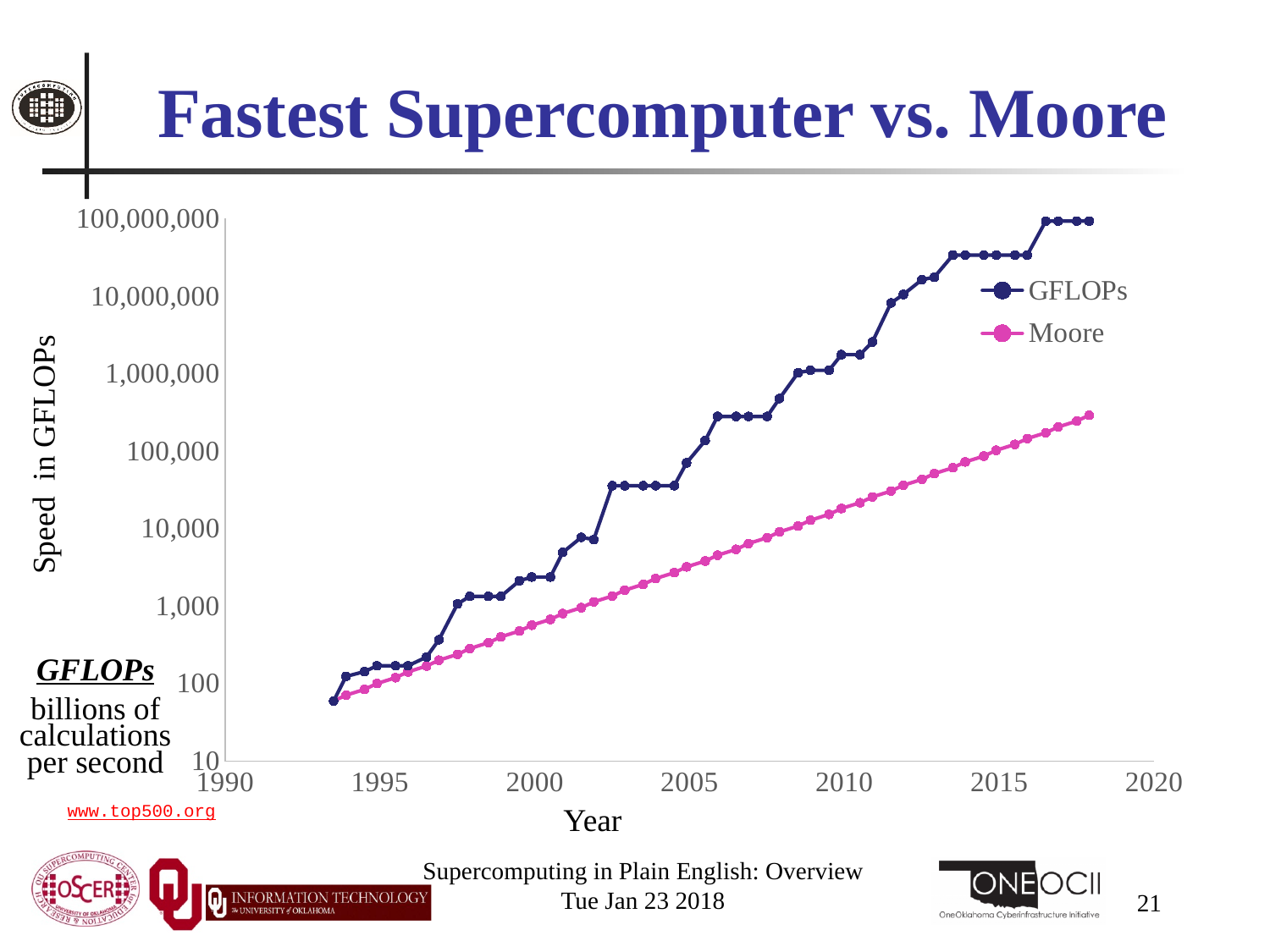
Is the Moore value in 2018 greater or less than 1,000,000? less Is the GFLOPs value in 2018 greater or less than 10,000,000? greater Is the GFLOPs value in 2005 greater or less than 10,000? greater Does the Moore series rise or fall as the year increases? rise How many series does the legend list? 2 In 2015, which series has the higher value, GFLOPs or Moore? GFLOPs What is the title of the chart? Fastest Supercomputer vs. Moore In 2010, which series has the higher value, GFLOPs or Moore? GFLOPs What are the two series named in the legend? GFLOPs and Moore What kind of chart is shown on the slide? line chart Does the GFLOPs series rise or fall as the year increases? rise